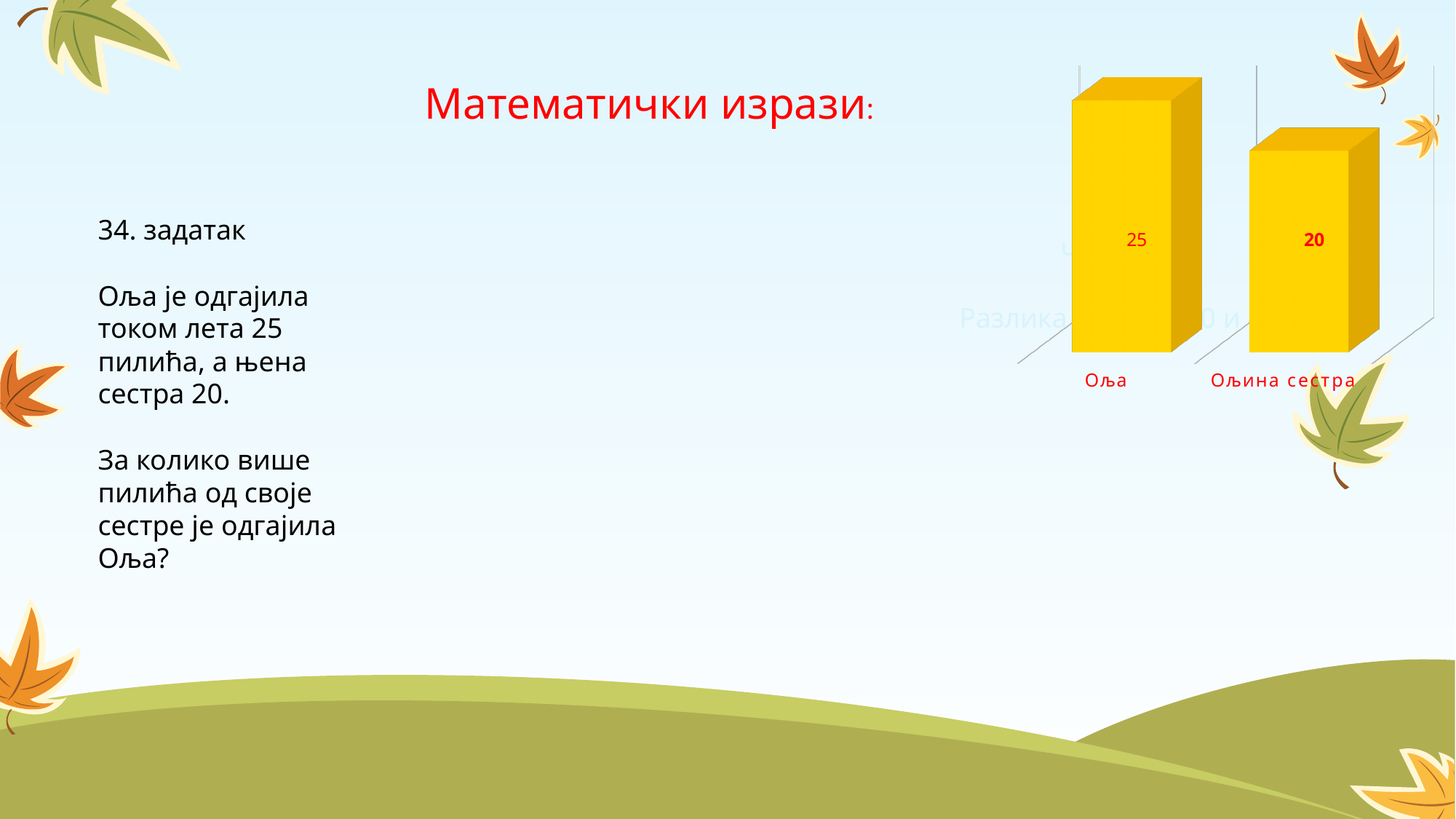
Which is larger, the value for Оља or the value for Ољина сестра? Оља What is the value of the bar for Оља? 25 Which category has the highest bar? Оља How many bars does the chart show? 2 What is the difference between the values for Оља and Ољина сестра? 5 What is the label of the first (left) bar in the chart? Оља What kind of chart is shown on the slide? Bar chart Which category has the lowest bar? Ољина сестра What colour are the bars in the chart? Yellow Do the values rise or fall from the left bar to the right bar? Fall What is the value of the bar for Ољина сестра? 20